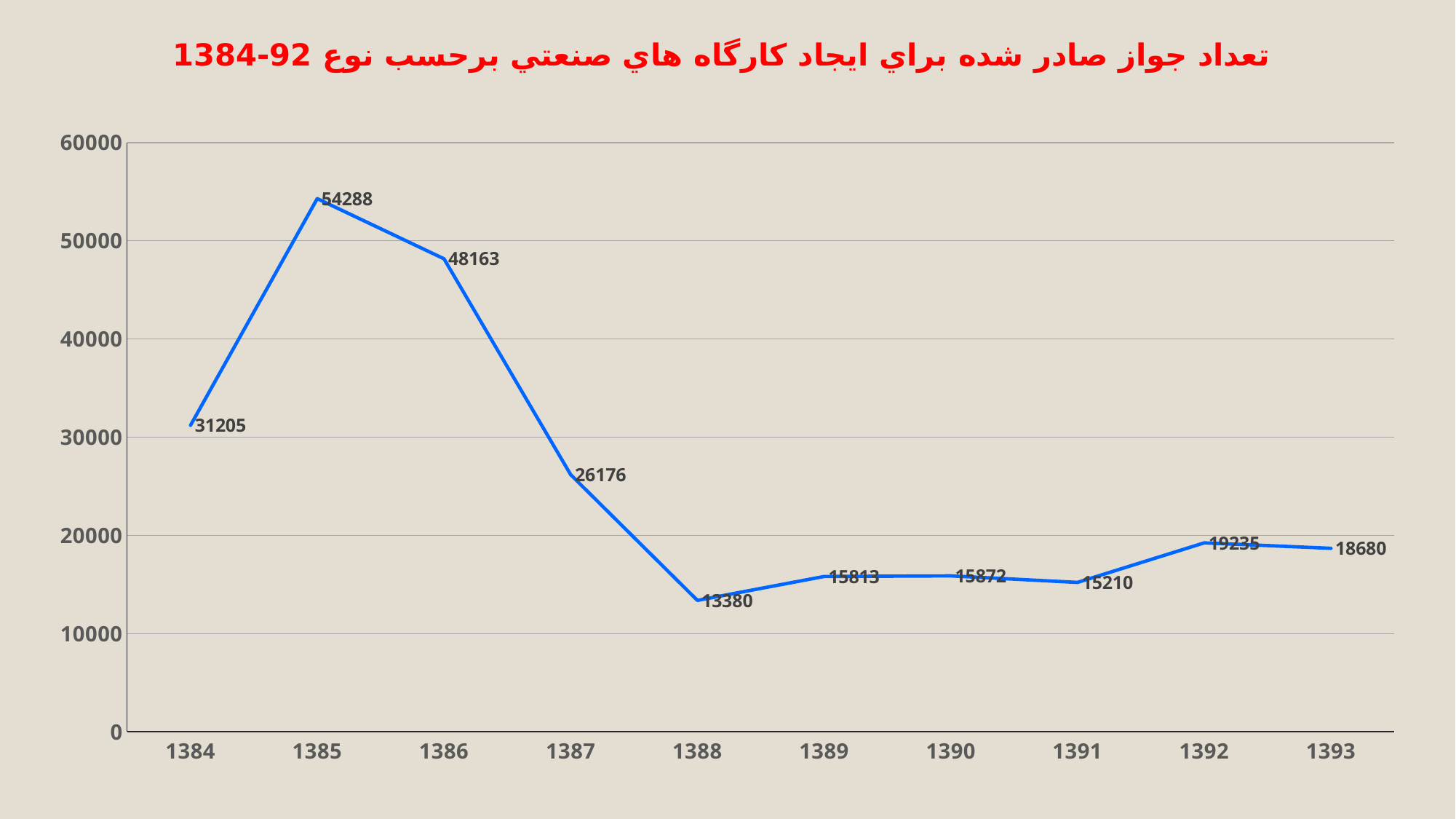
Which is larger, the value for 1384 or the value for 1387? 1384 What is the value for 1388? 13380 Do the values rise or fall from 1385 to 1388? fall What is the difference between the values for 1385 and 1386? 6125 How many years are plotted on the x axis? 10 Is the value for 1386 greater or less than 40000? greater What is the value for 1393? 18680 Which year has the lowest value? 1388 Which year has the highest value? 1385 What kind of chart is shown on the slide? line chart What is the value for 1385? 54288 What is the difference between the values for 1392 and 1393? 555